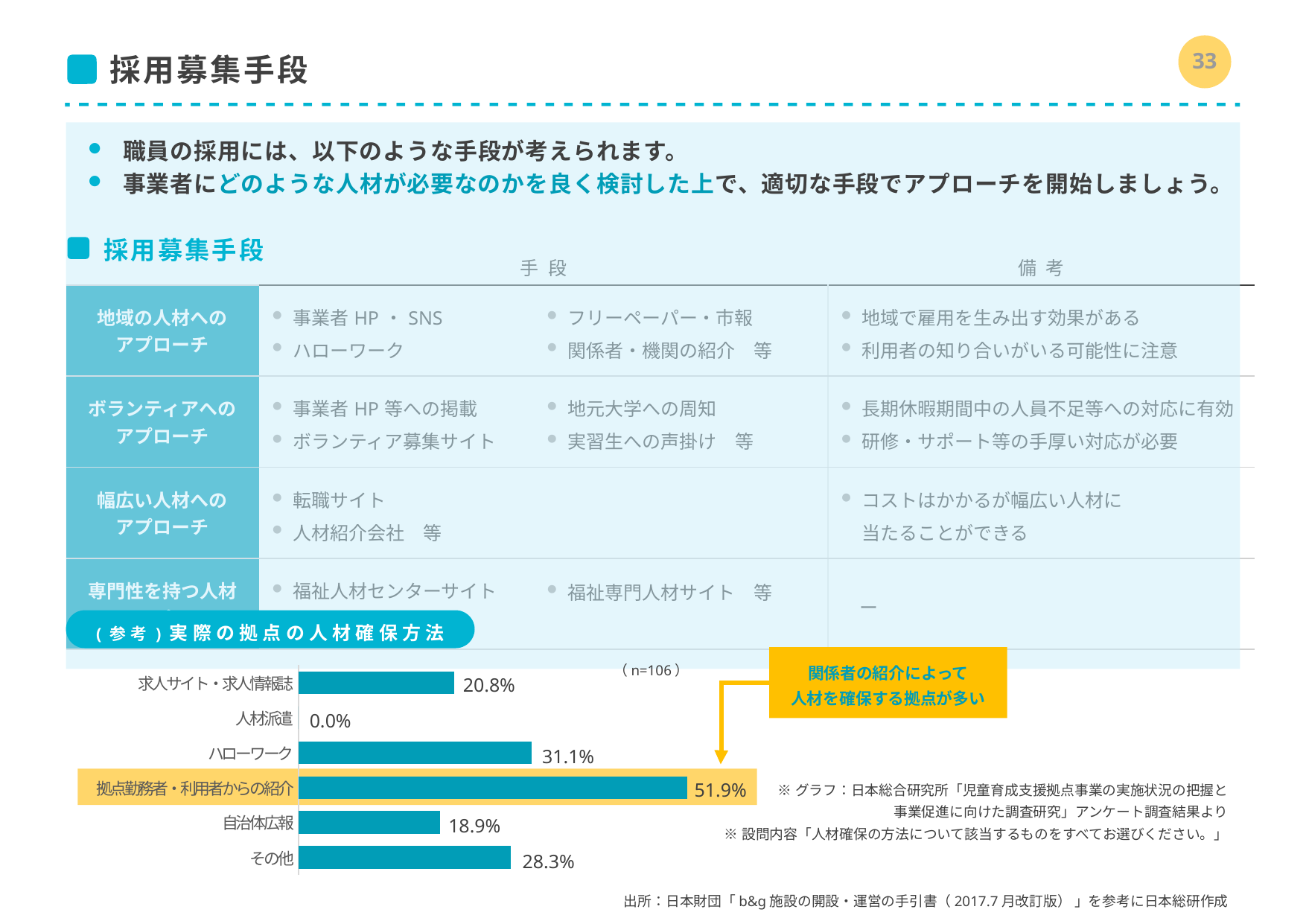
What is the value for 拠点勤務者・利用者からの紹介 in the bar chart? 51.9% What is the difference between the values for その他 and 求人サイト・求人情報誌? 7.5% Which category has the lowest value in the bar chart? 人材派遣 What kind of chart is shown at the bottom of the slide? Bar chart What is the value for ハローワーク in the bar chart? 31.1% What is the value for 自治体広報 in the bar chart? 18.9% How many categories are shown in the bar chart? 6 What is the sample size (n) shown next to the bar chart? n=106 Which is larger, the value for ハローワーク or the value for その他? ハローワーク What is the difference between the values for 拠点勤務者・利用者からの紹介 and ハローワーク? 20.8% What is the value for 人材派遣 in the bar chart? 0.0% Which category has the highest value in the bar chart? 拠点勤務者・利用者からの紹介